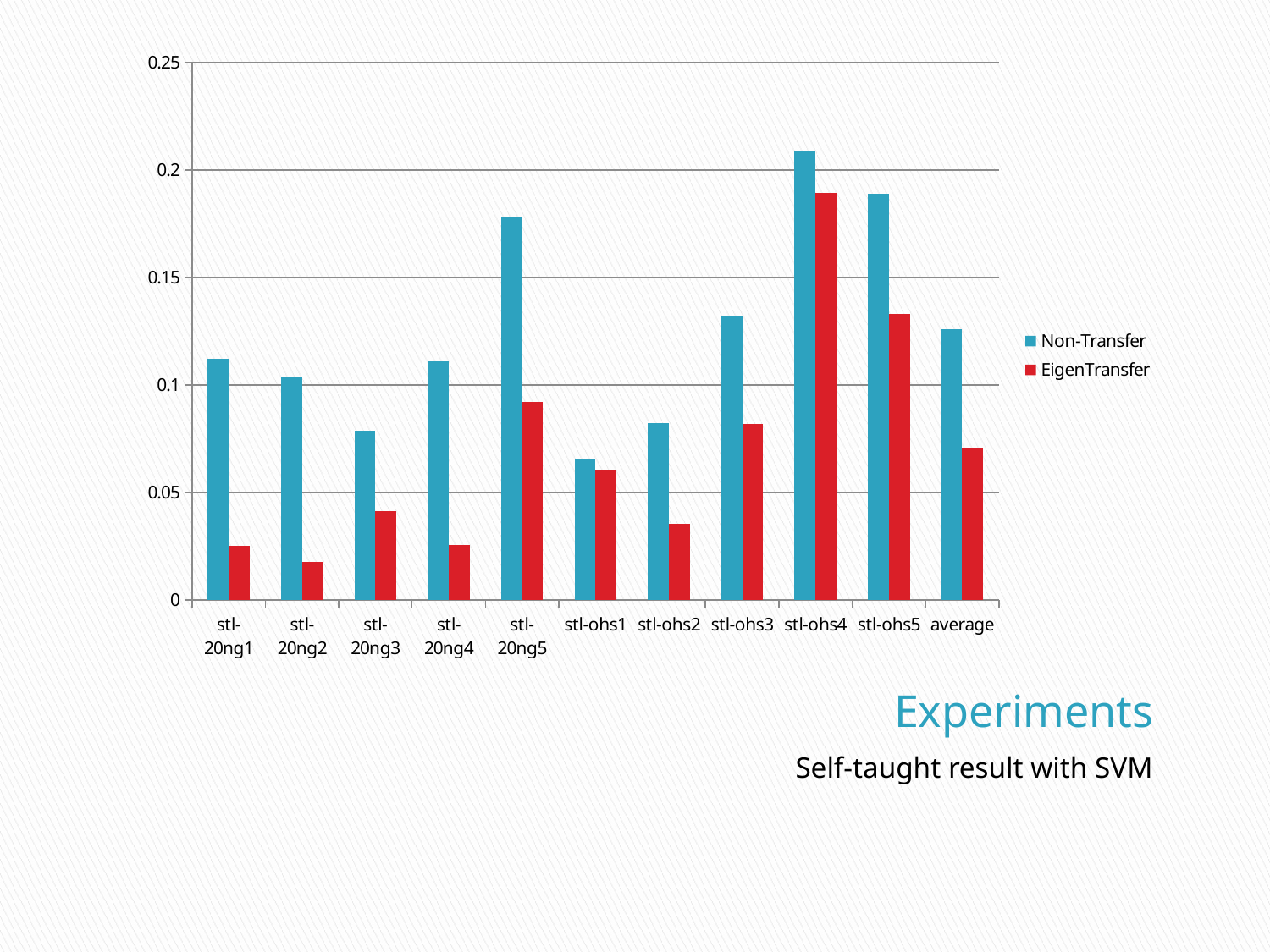
Which category has the highest EigenTransfer value? stl-ohs4 What kind of chart is shown on the slide? bar chart How many series does the legend list? 2 How many categories are shown along the x axis? 11 Which category has the lowest EigenTransfer value? stl-20ng2 Is the EigenTransfer value for stl-ohs5 greater or less than 0.15? less Which series is shown in red in the legend? EigenTransfer Which category has the highest Non-Transfer value? stl-ohs4 For stl-20ng1, which is larger: the Non-Transfer value or the EigenTransfer value? Non-Transfer Which category has the lowest Non-Transfer value? stl-ohs1 Is the Non-Transfer value for stl-20ng5 greater or less than 0.15? greater Is the Non-Transfer value for stl-ohs4 greater or less than 0.2? greater